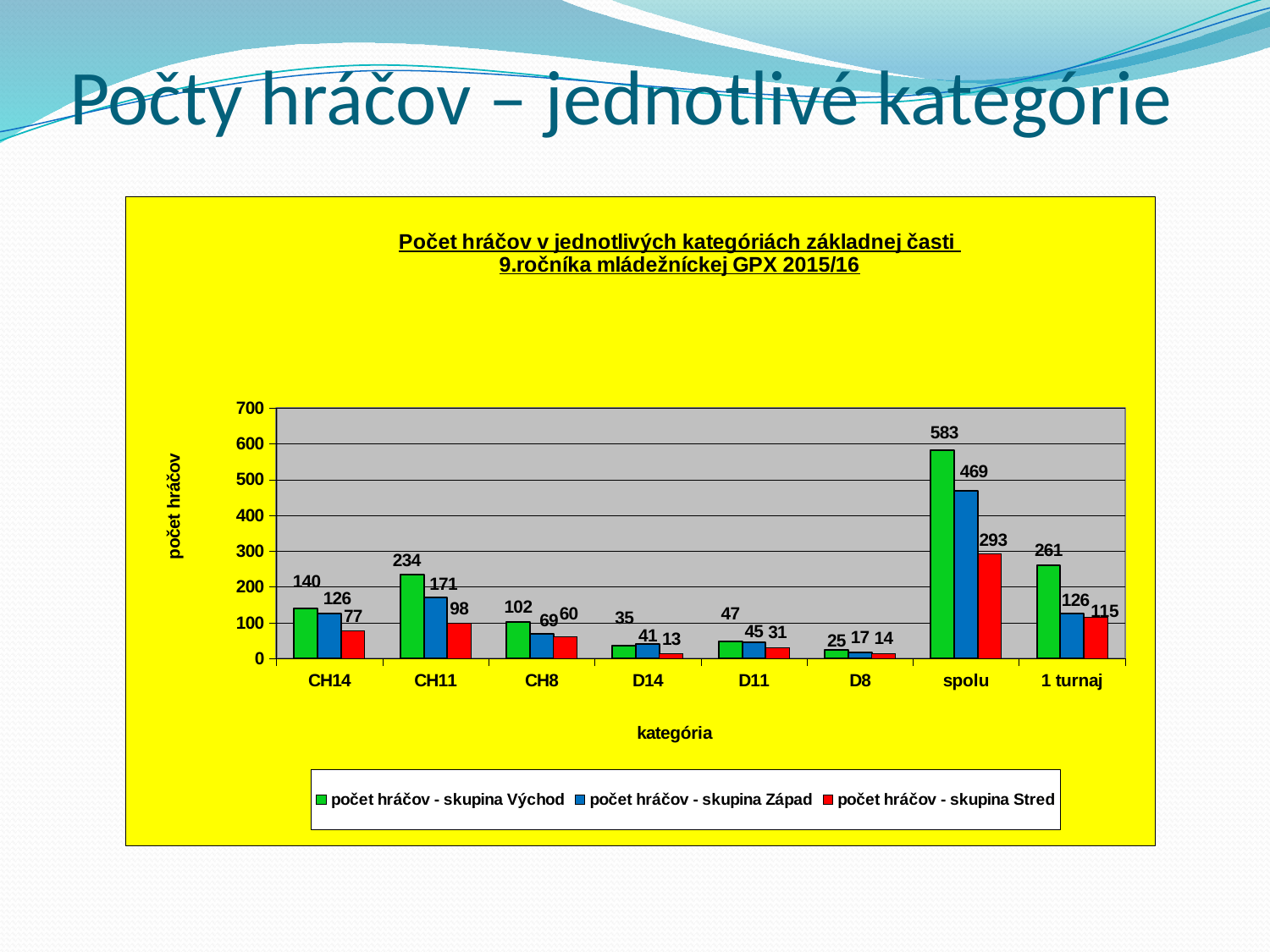
Which category has the lowest value for skupina Stred? D14 How many series does the legend list? 3 What is the value for skupina Stred in category spolu? 293 Which is larger in category D14: skupina Východ or skupina Západ? skupina Západ What is the value for skupina Západ in category D14? 41 Is the value for skupina Východ in category 1 turnaj greater or less than 200? greater What is the difference between skupina Východ and skupina Západ in category spolu? 114 What is the label of the y axis? počet hráčov What is the value for skupina Východ in category CH11? 234 What kind of chart is shown on the slide? bar chart Which category has the highest value for skupina Východ? spolu How many categories are shown on the x axis? 8